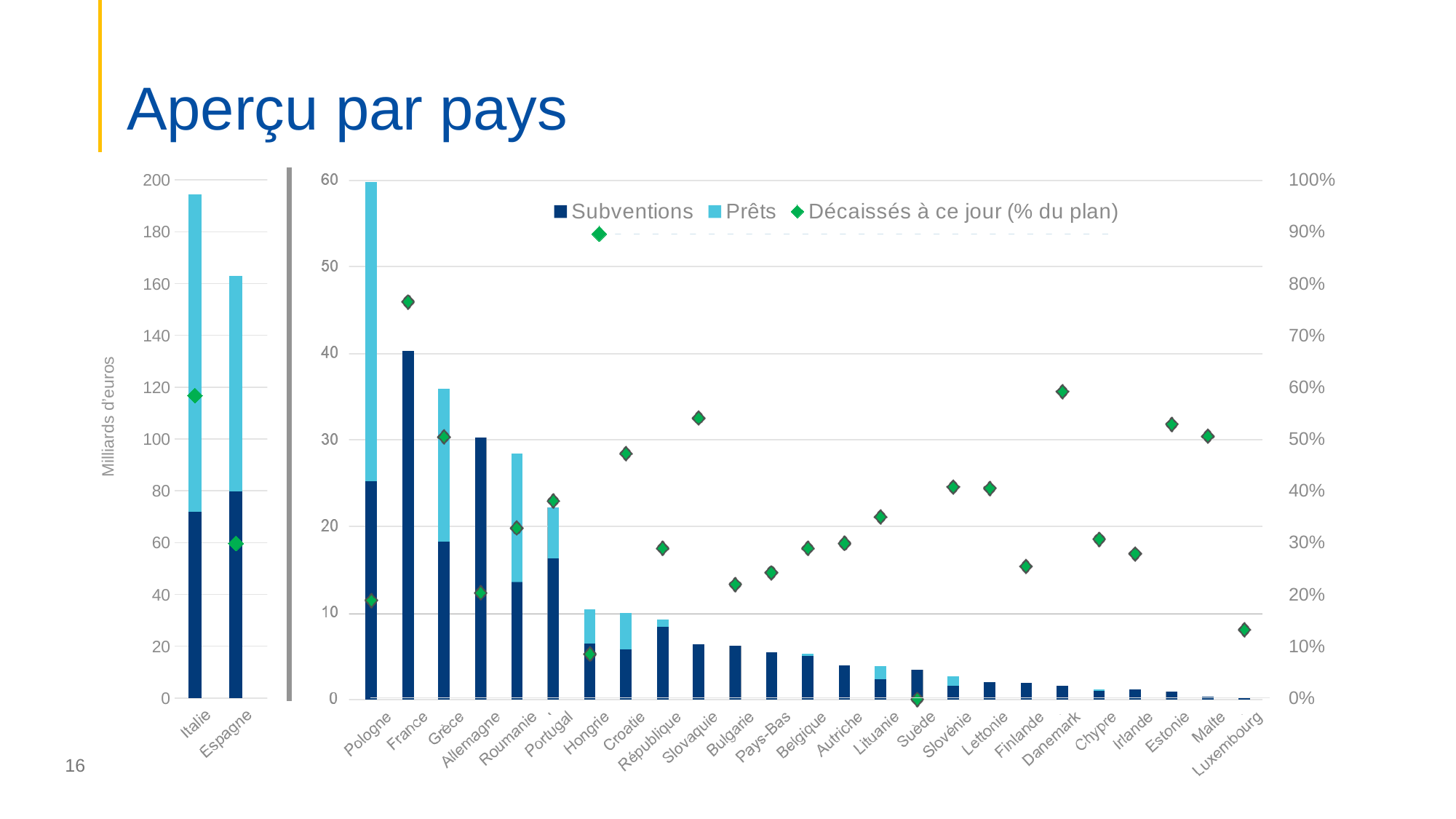
On the right-hand chart, is the 'Décaissés à ce jour' marker for France greater or less than 70%? greater On the left-hand chart, is the total stacked bar for Italie greater or less than 180? greater On the right-hand chart, do the stacked bar totals generally rise or fall from left to right along the x axis? fall On the right-hand chart, which country has the largest Subventions (dark blue) segment? France What kind of chart is the right-hand chart on the slide? bar chart (stacked, with diamond markers) On the right-hand chart, which country has the tallest stacked bar? Pologne How many countries are shown on the left-hand chart? 2 How many series does the legend of the right-hand chart list? 3 On the right-hand chart, is the total stacked bar for France greater or less than 50? less What is the label on the vertical axis of the left-hand chart? Milliards d'euros On the left-hand chart, which country has the taller stacked bar, Italie or Espagne? Italie How many countries are shown on the right-hand chart? 25